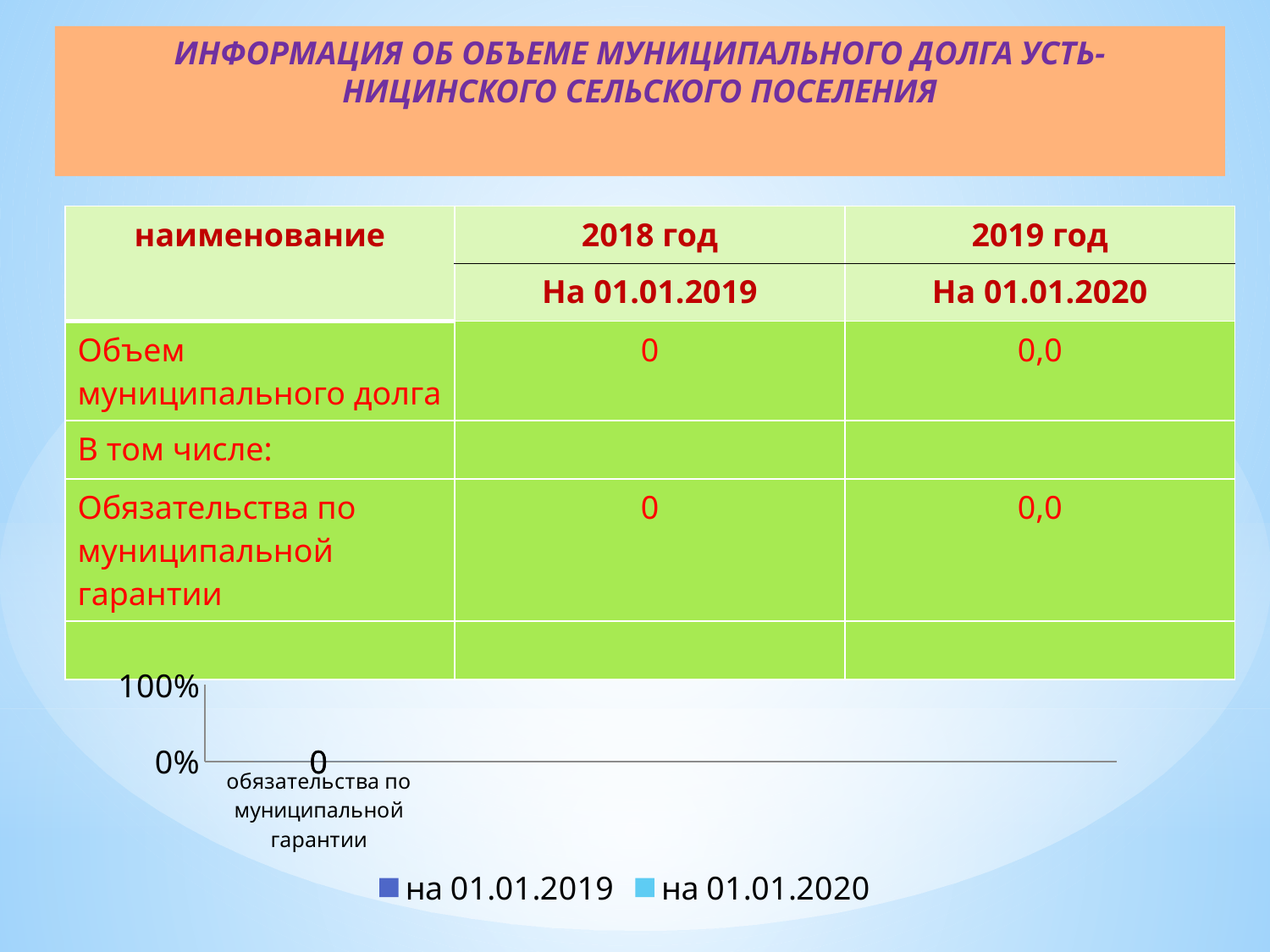
What data label is printed for the category 'обязательства по муниципальной гарантии' in the chart? 0 Is the value for 'обязательства по муниципальной гарантии' in the chart greater or less than 100%? less How many categories are shown on the x axis of the chart? 1 What are the two series named in the chart legend? на 01.01.2019 and на 01.01.2020 What kind of chart is shown at the bottom of the slide? bar chart How many series does the chart legend list? 2 What is the highest value shown on the chart's vertical axis? 100%